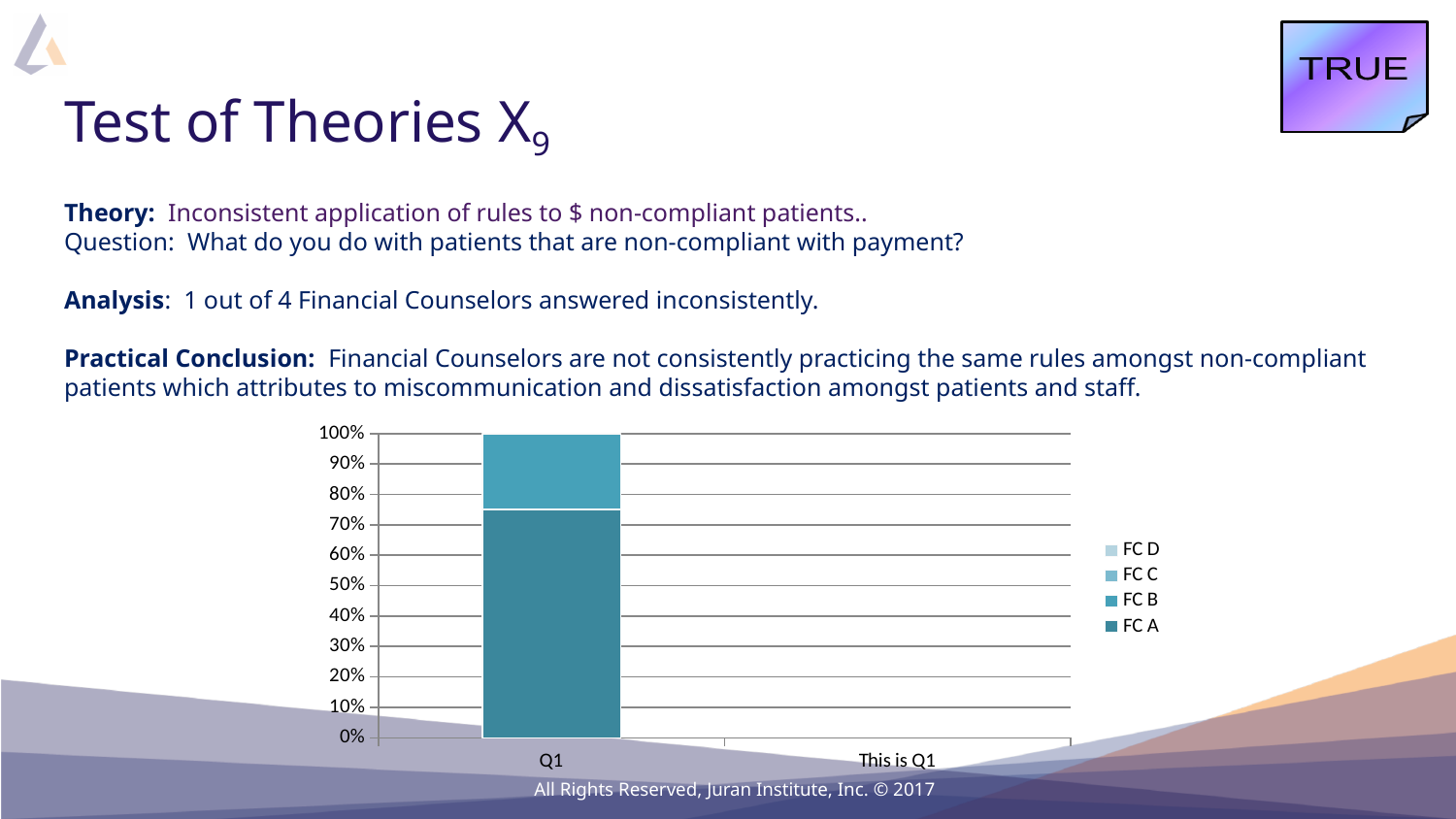
Is the FC A segment of the Q1 bar greater or less than 80%? less Which series has the largest segment in the Q1 bar? FC A What are the entries in the chart legend? FC D, FC C, FC B, FC A How many series does the chart legend list? 4 Is the FC A segment of the Q1 bar greater or less than 50%? greater What kind of chart is shown on the slide? Stacked bar chart How many visible segments make up the Q1 stacked bar? 2 Is the top of the Q1 stacked bar greater or less than 90%? greater Which category has the taller bar, Q1 or This is Q1? Q1 What is the total height of the stacked bar for Q1? 100% What is the label of the second category on the x axis? This is Q1 How many categories are shown on the x axis of the chart? 2